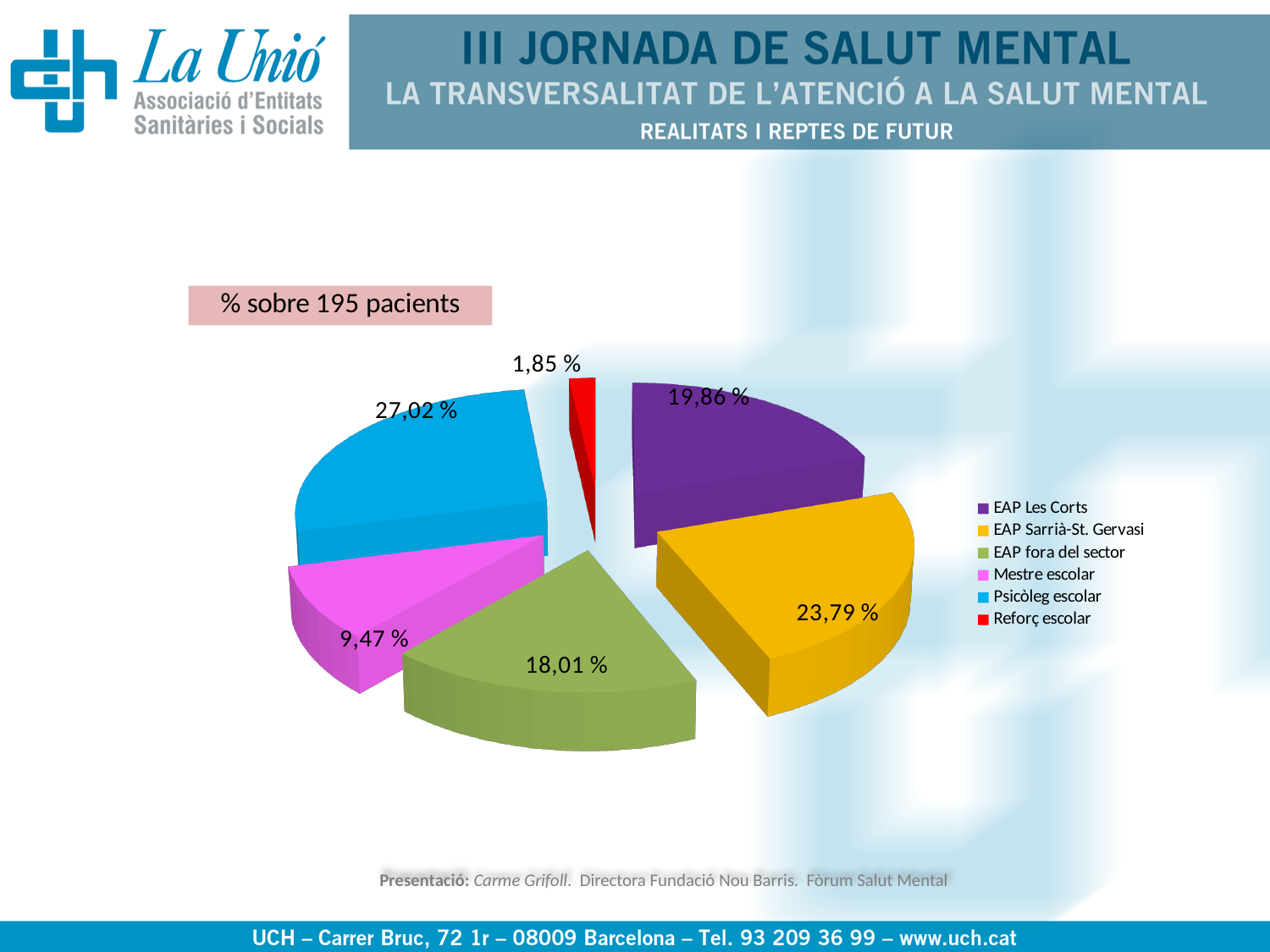
What percentage is shown for EAP Sarrià-St. Gervasi? 23,79 % How many slices does the pie chart have? 6 What kind of chart is shown on the slide? Pie chart Which is larger, EAP fora del sector or EAP Les Corts? EAP Les Corts What percentage is shown for EAP Les Corts? 19,86 % Which category has the smallest share of the pie? Reforç escolar Which colour represents EAP fora del sector in the legend? Green Which category has the largest share of the pie? Psicòleg escolar What percentage is shown for Mestre escolar? 9,47 % What percentage is shown for Psicòleg escolar? 27,02 % What is the difference between the percentages for Psicòleg escolar and Reforç escolar? 25,17 % What is the title of the chart? % sobre 195 pacients